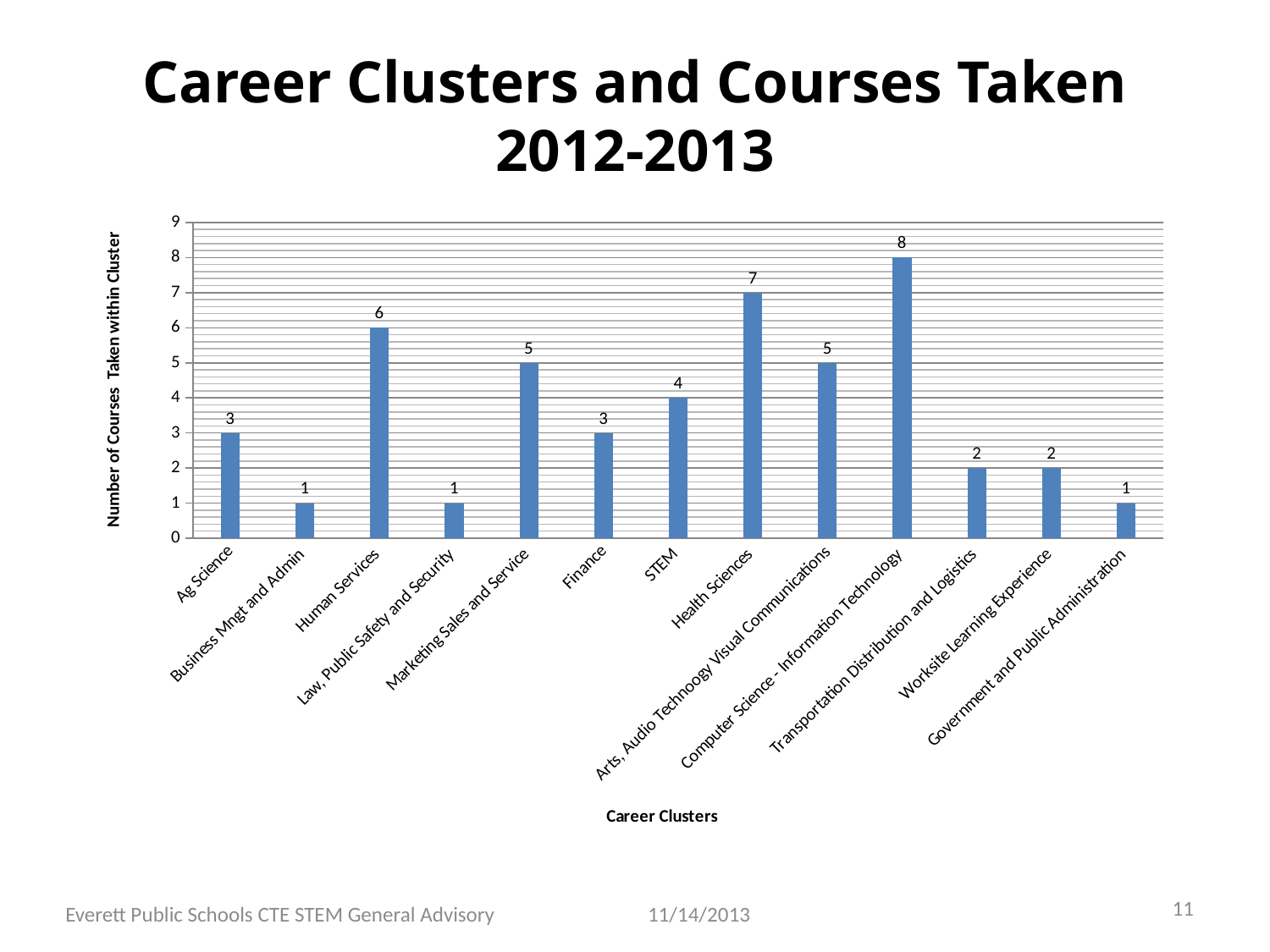
What is the value for Worksite Learning Experience? 2 How many courses were taken within the Health Sciences cluster? 7 What is the value for Ag Science? 3 What is the difference between the values for Computer Science - Information Technology and STEM? 4 What is the value for Human Services? 6 What is the difference between the values for Health Sciences and Arts, Audio Technoogy Visual Communications? 2 How many career clusters are shown on the x axis? 13 Which is larger, the value for Marketing Sales and Service or the value for Finance? Marketing Sales and Service Which career cluster has the highest number of courses taken? Computer Science - Information Technology How many clusters have a value of 1? 3 What is the title of the y axis? Number of Courses Taken within Cluster What kind of chart is shown on the slide? Bar chart